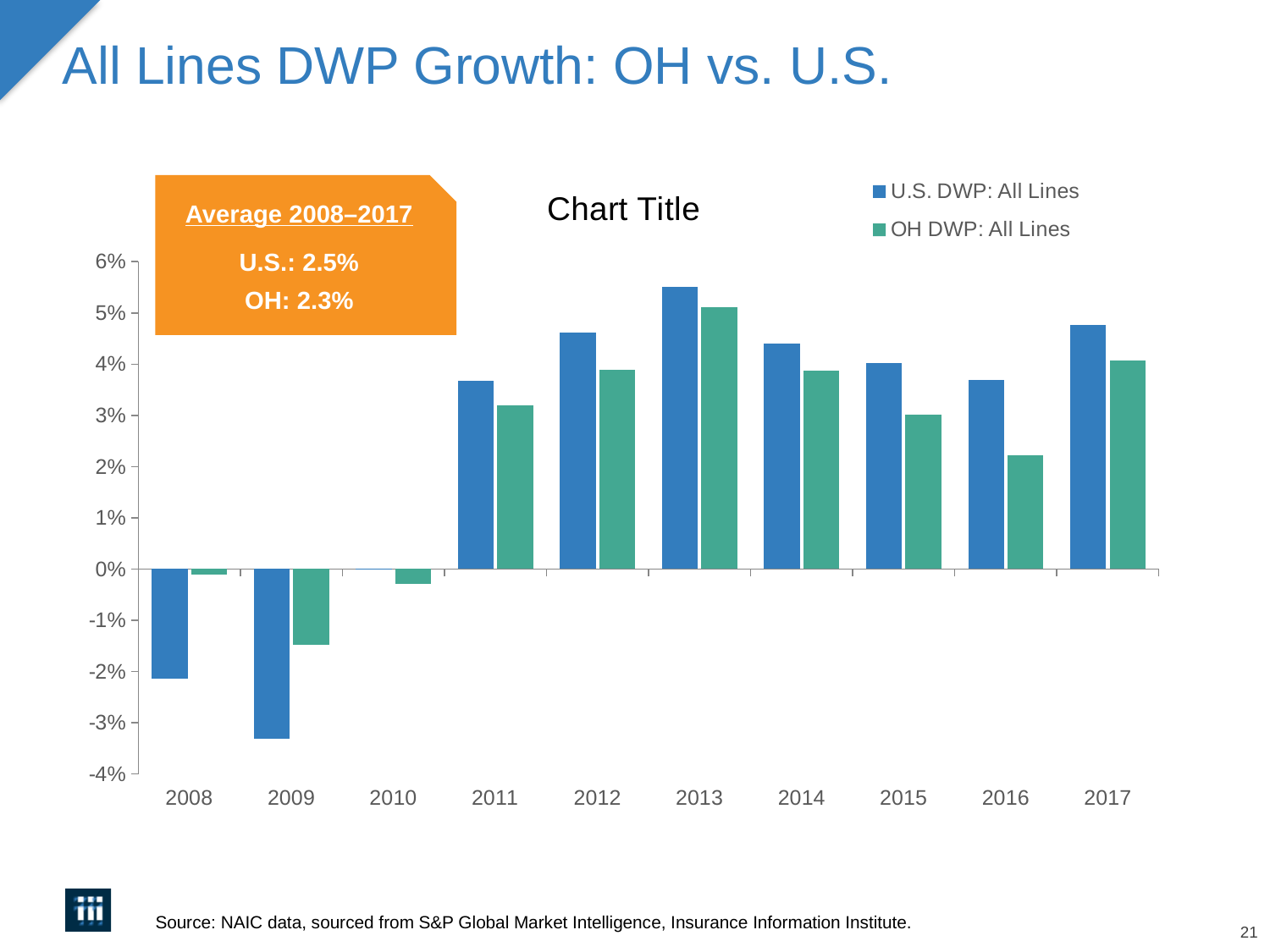
In which year is U.S. DWP: All Lines growth lowest? 2009 Is the value for U.S. DWP: All Lines in 2009 greater or less than -3%? less What kind of chart is shown on the slide? bar chart Is the value for U.S. DWP: All Lines in 2013 greater or less than 5%? greater In 2016, which is larger: U.S. DWP: All Lines or OH DWP: All Lines? U.S. DWP: All Lines According to the callout box, what is the average U.S. DWP growth for 2008–2017? 2.5% Is the value for OH DWP: All Lines in 2016 greater or less than 3%? less In which year is OH DWP: All Lines growth highest? 2013 In which year is U.S. DWP: All Lines growth highest? 2013 How many years are shown on the x axis? 10 In which year is OH DWP: All Lines growth lowest? 2009 How many series does the legend list? 2